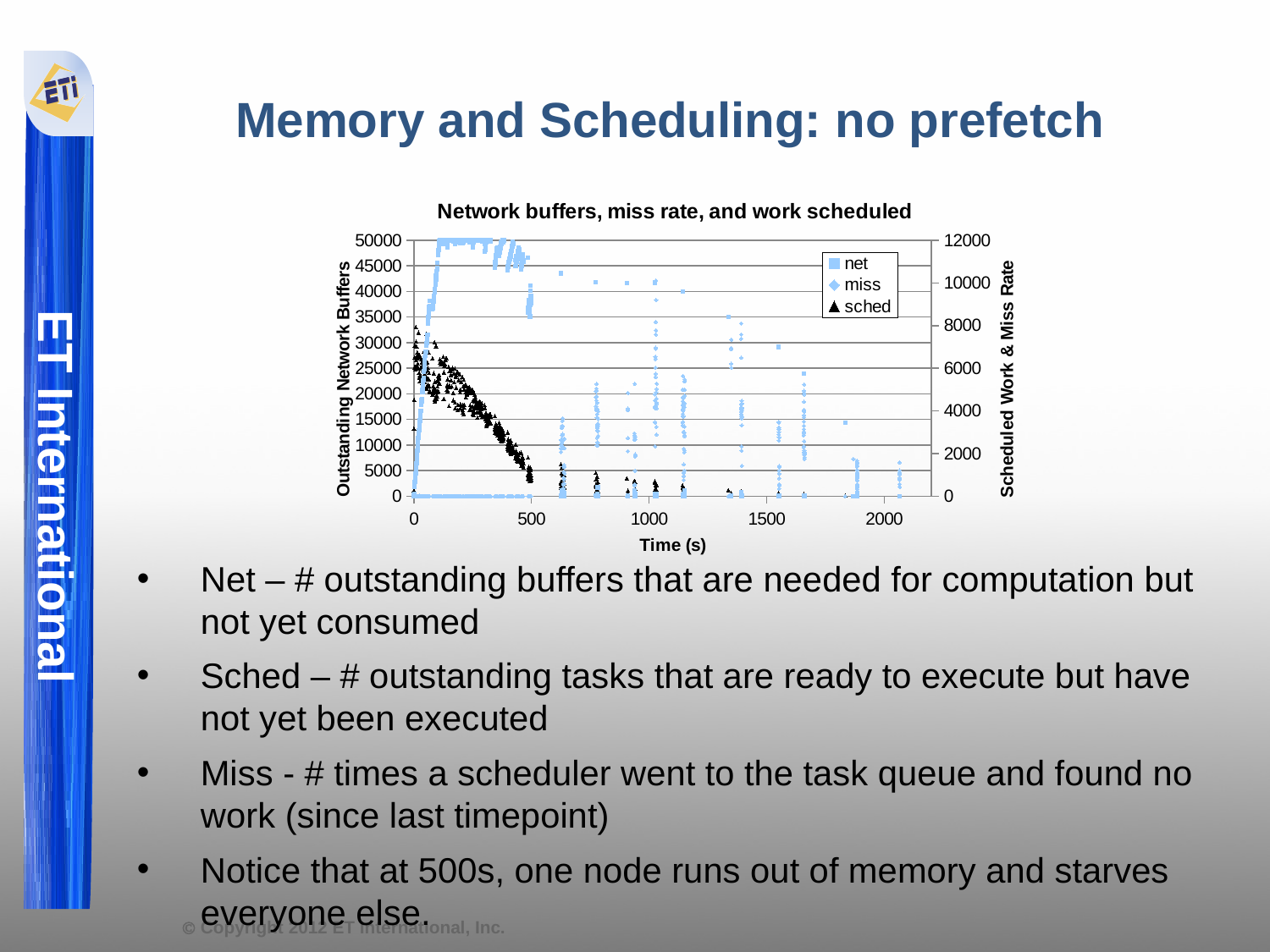
Do the sched values rise or fall between time 0 and time 500 s? fall Is the net value between about 100 s and 400 s greater or less than 40000 on the left axis? greater Which series is plotted with triangle markers? sched What is the label of the x axis? Time (s) What is the highest value shown on the right y axis? 12000 What is the title of the chart? Network buffers, miss rate, and work scheduled What is the highest value shown on the left y axis? 50000 How many series does the legend list? 3 What is the largest tick value shown on the x axis? 2000 What are the three series named in the legend? net, miss, sched What kind of chart is shown on the slide? scatter chart